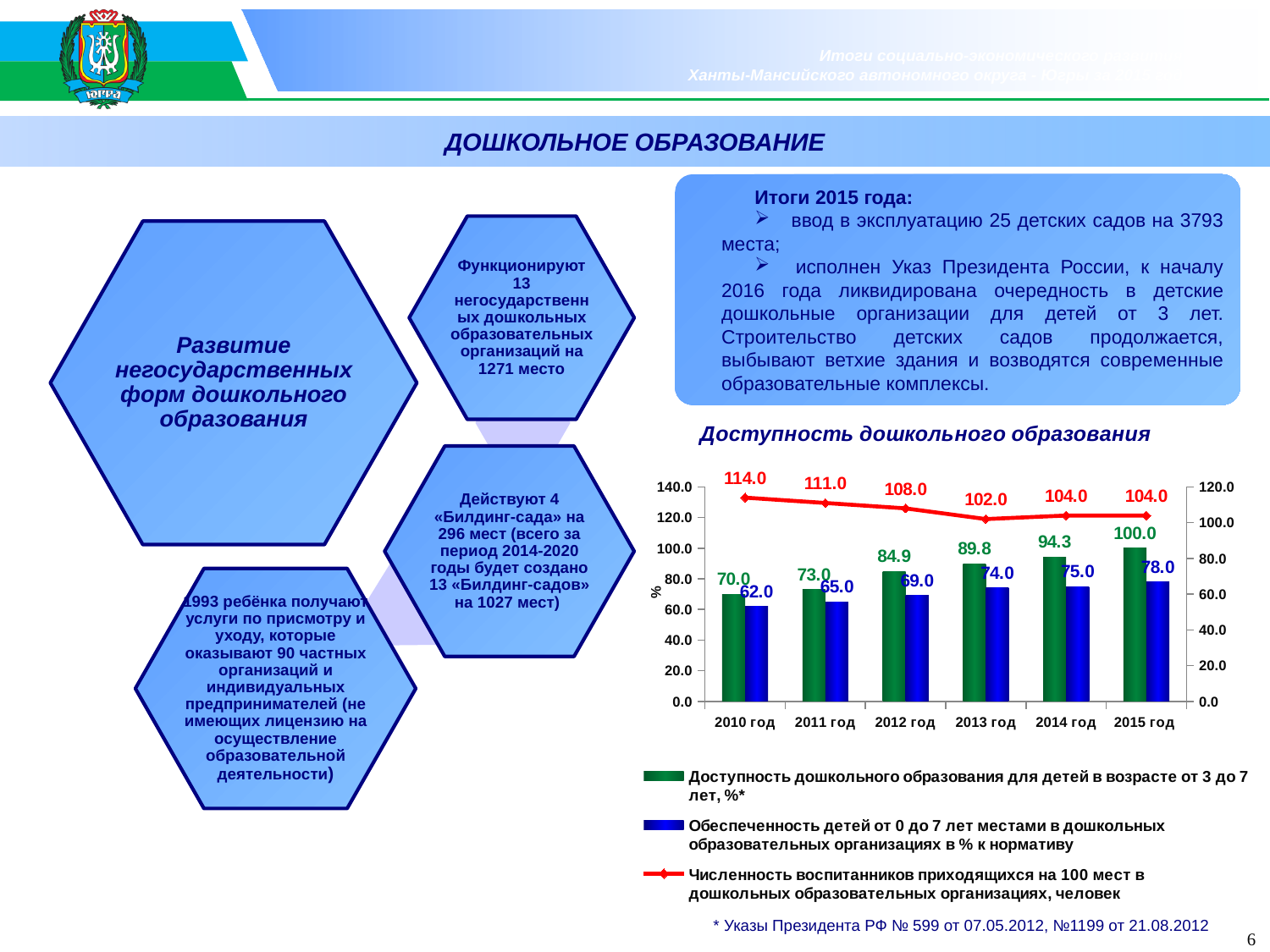
What is the value of the green series (Доступность дошкольного образования для детей в возрасте от 3 до 7 лет) for 2015 год? 100.0 What kind of chart is used for 'Доступность дошкольного образования'? a combined bar and line chart What is the difference between the green and blue bar values for 2014 год? 19.3 Does the green series (Доступность для детей от 3 до 7 лет) rise or fall from 2010 год to 2015 год? rise What is the value of the red line (Численность воспитанников приходящихся на 100 мест) for 2010 год? 114.0 What is the value of the blue series (Обеспеченность детей от 0 до 7 лет местами) for 2012 год? 69.0 How many years are shown on the x axis of the chart? 6 Which is larger in 2011 год: the green bar (Доступность для детей от 3 до 7 лет) or the blue bar (Обеспеченность детей от 0 до 7 лет)? the green bar (73.0) What is the title of the chart on the slide? Доступность дошкольного образования In which year is the green series (Доступность дошкольного образования для детей от 3 до 7 лет) at its highest? 2015 год How many series does the chart legend list? 3 In which year is the red line (Численность воспитанников на 100 мест) at its lowest? 2013 год